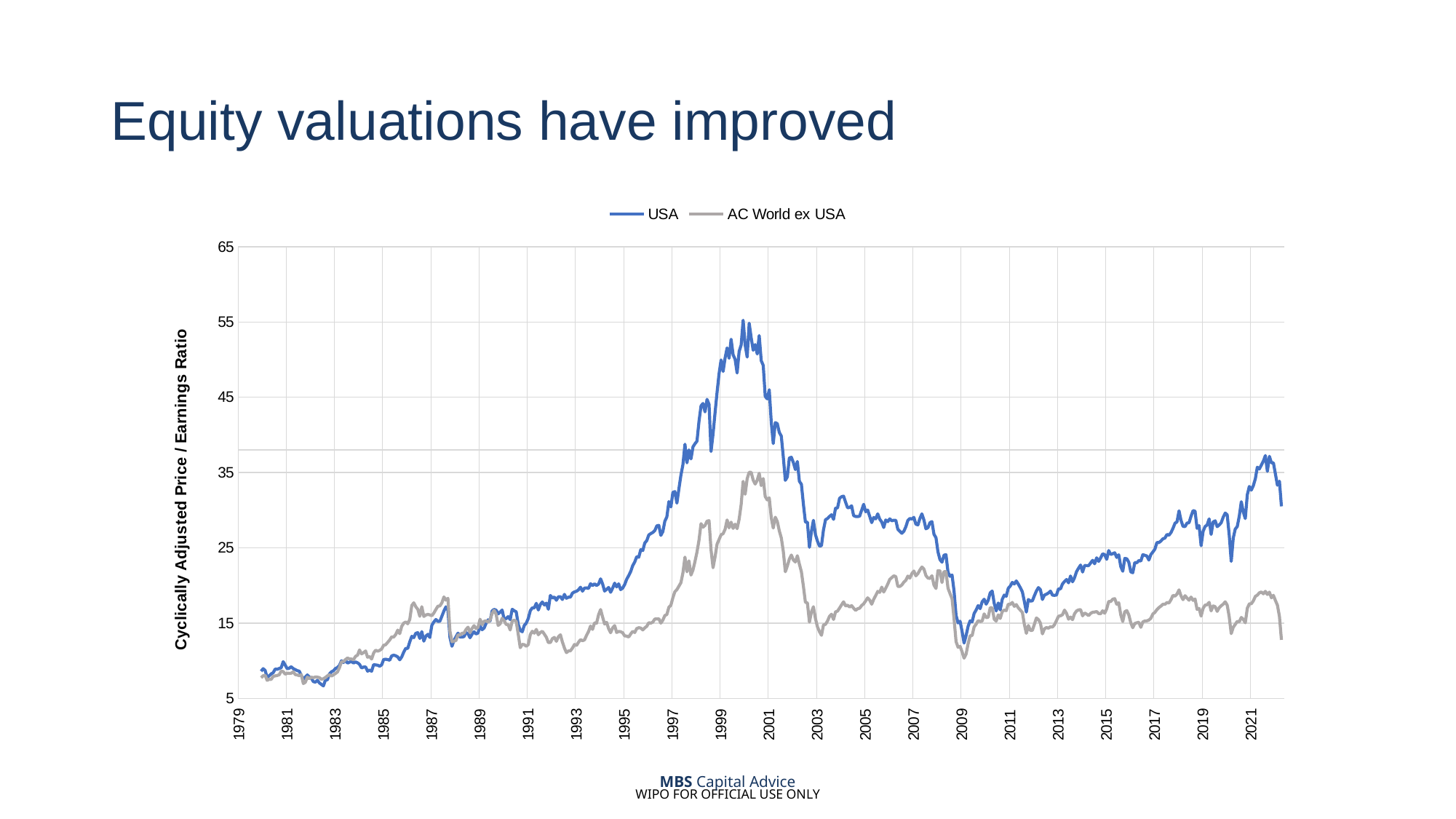
What is the label of the vertical axis? Cyclically Adjusted Price / Earnings Ratio Which series reaches the higher peak around the year 2000, USA or AC World ex USA? USA What are the two series named in the legend? USA and AC World ex USA Is the peak value of the AC World ex USA series around 2000 greater or less than 45? less How many series does the legend list? 2 Is the value of the AC World ex USA series in 2021 greater or less than 25? less Which series is higher in 2021, USA or AC World ex USA? USA Does the USA series rise or fall between 2009 and 2021? rise Is the peak value of the USA series around 2000 greater or less than 45? greater Does the USA series rise or fall between 2000 and 2003? fall What kind of chart is shown on the slide? line chart